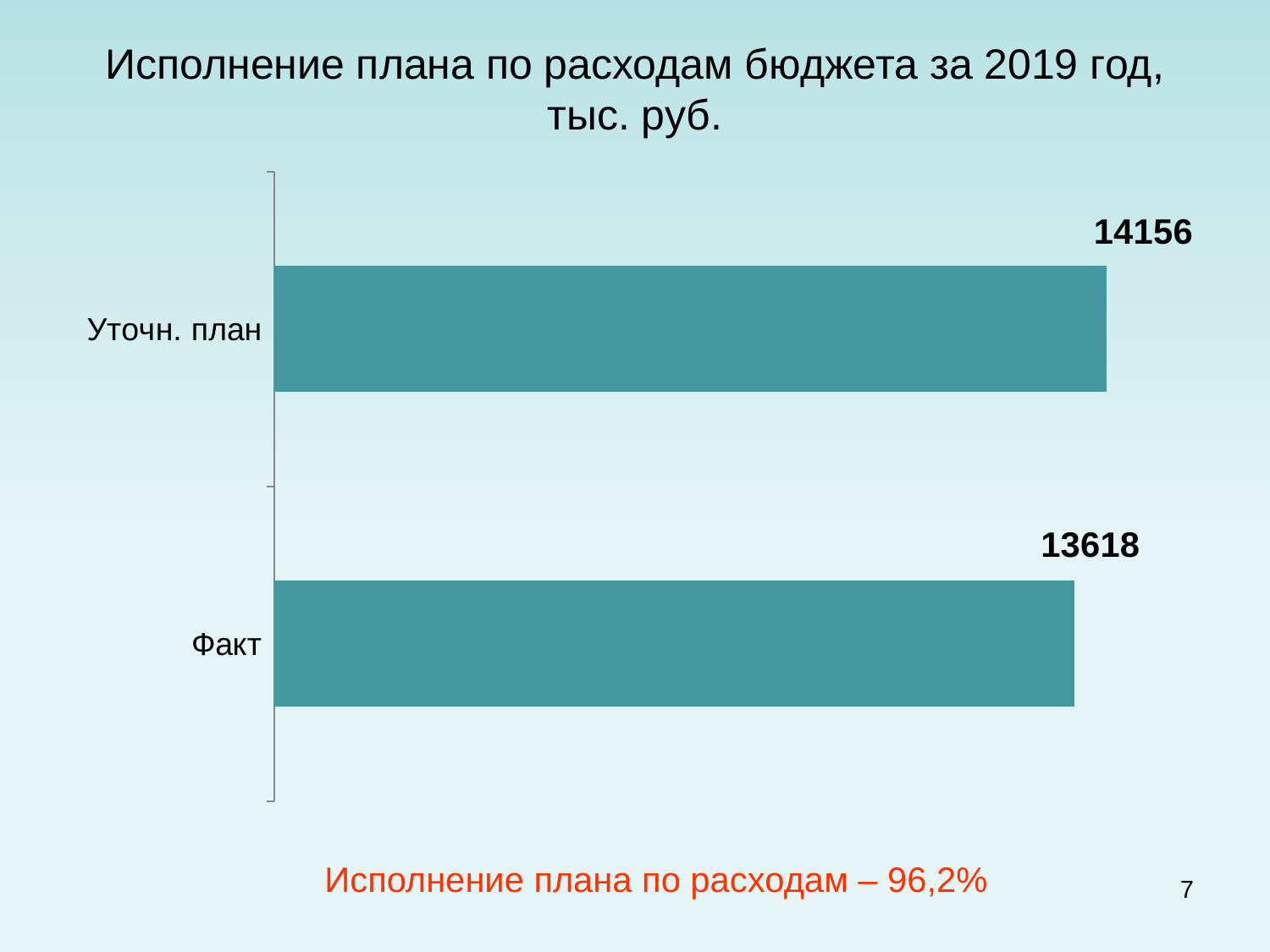
What kind of chart is shown on the slide? bar chart Which category has the highest value? Уточн. план What is the value for Уточн. план? 14156 Which category has the lowest value? Факт What is the title of the chart? Исполнение плана по расходам бюджета за 2019 год, тыс. руб. What is the value for Факт? 13618 How many categories are shown in the chart? 2 What is the difference between the values for Уточн. план and Факт? 538 What percentage of plan execution for expenditures is stated below the chart? 96,2% Which is larger, the value for Уточн. план or the value for Факт? Уточн. план